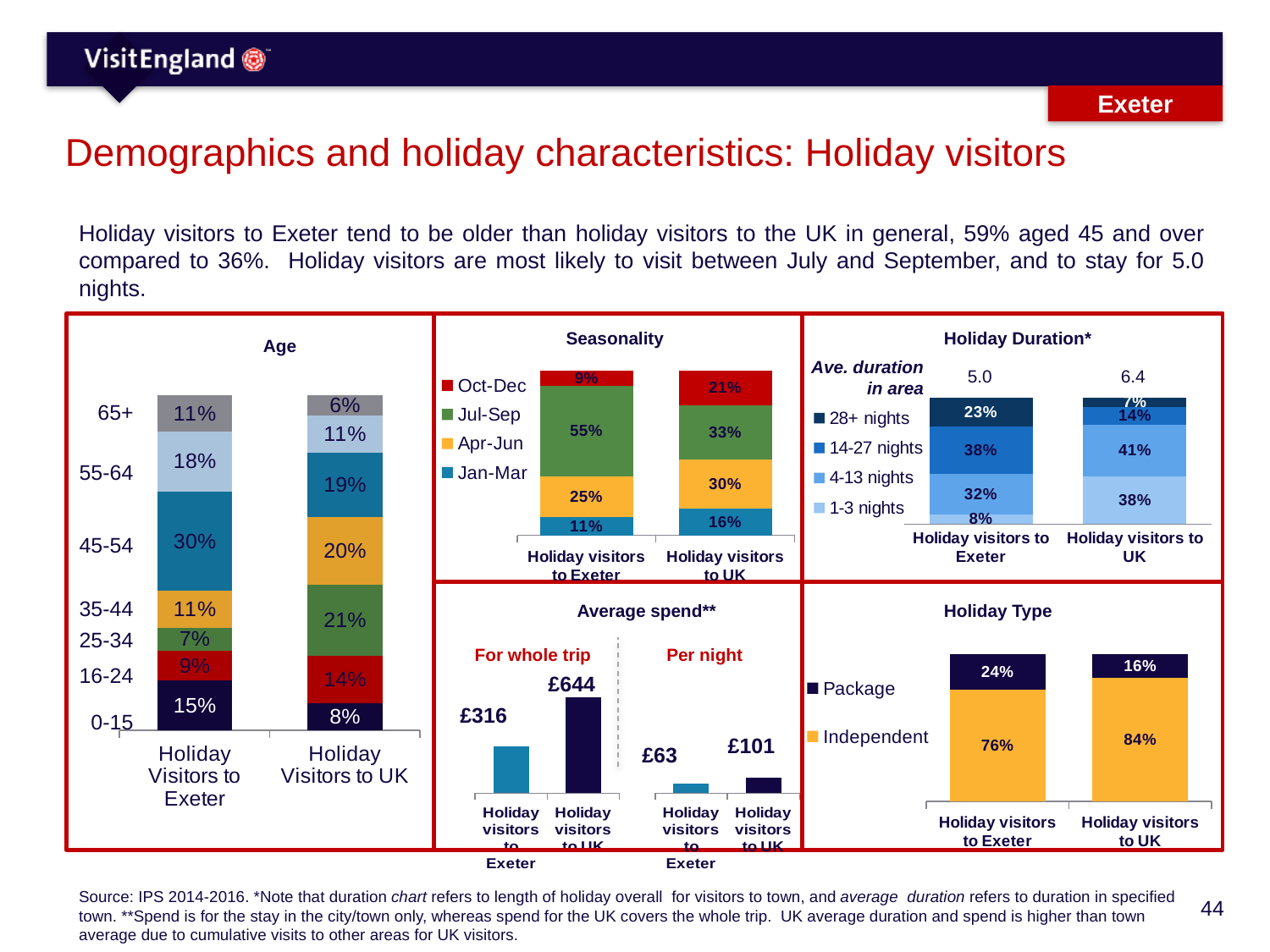
In the Age chart, what percentage of holiday visitors to Exeter are aged 45-54? 30% In the Holiday Duration chart, what percentage of holiday visitors to the UK stay 4-13 nights? 41% In the Seasonality chart, what percentage of holiday visitors to Exeter visit in Jul-Sep? 55% In the Average spend chart, what is the average spend for the whole trip for holiday visitors to Exeter? £316 In the Seasonality chart, how many series does the legend list? 4 In the Holiday Type chart, which group has the larger Independent share, holiday visitors to Exeter or holiday visitors to the UK? Holiday visitors to UK In the Holiday Duration chart, what is the average duration in area for holiday visitors to the UK? 6.4 In the Age chart, what is the difference between the 0-15 share for holiday visitors to Exeter and for holiday visitors to the UK? 7% In the Holiday Type chart, what percentage of holiday visitors to Exeter take a package holiday? 24% In the Average spend chart, what is the difference between the per night spend of holiday visitors to the UK and holiday visitors to Exeter? £38 In the Seasonality chart, which quarter has the smallest share of holiday visitors to the UK? Jan-Mar In the Age chart, what percentage of holiday visitors to the UK are aged 65+? 6%